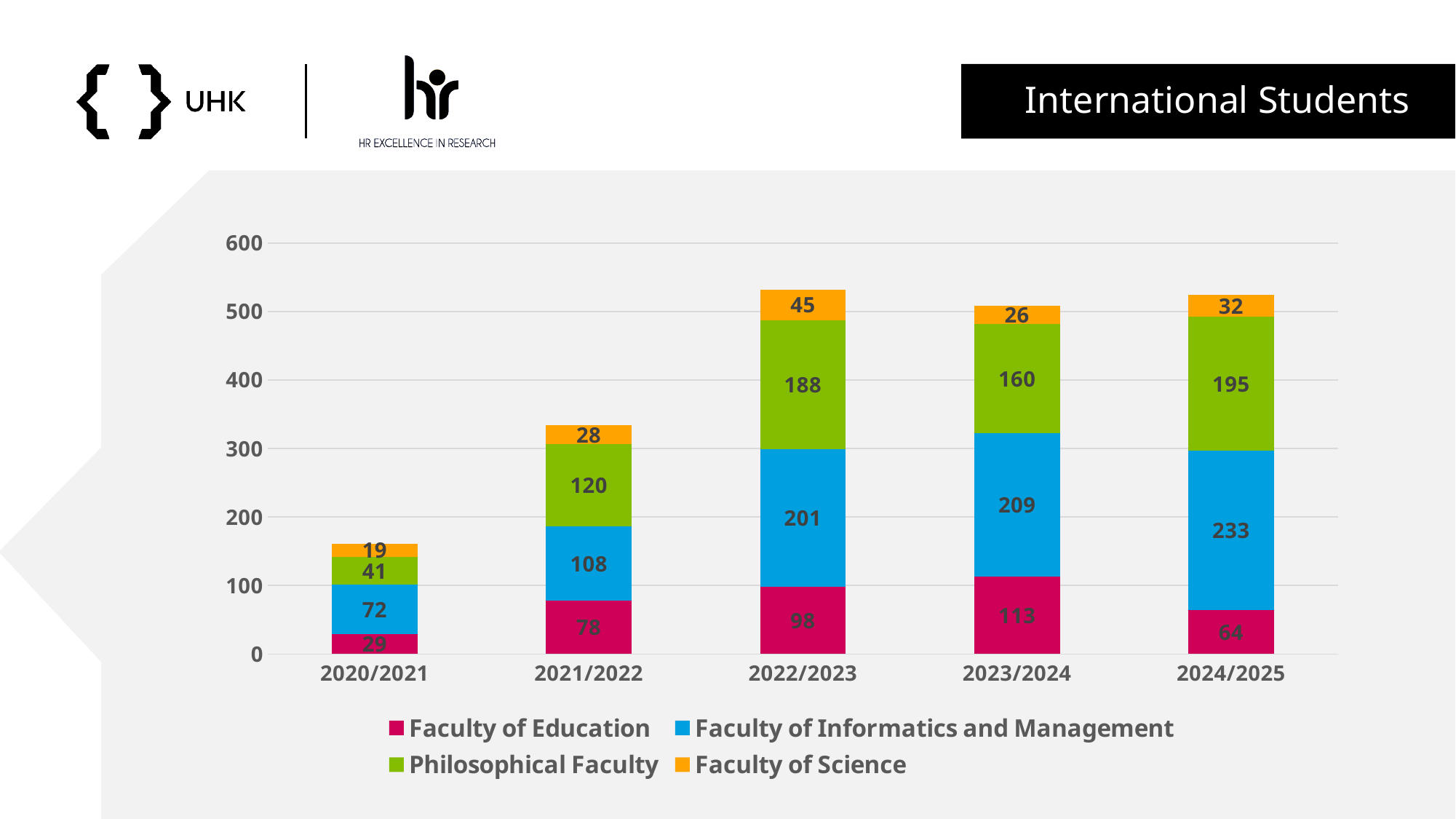
What is the value for the Faculty of Science in 2020/2021? 19 What is the value for the Faculty of Informatics and Management in 2024/2025? 233 In which academic year is the Faculty of Education value highest? 2023/2024 What kind of chart is shown on the slide? stacked bar chart What is the value for the Philosophical Faculty in 2022/2023? 188 How many series does the legend list? 4 Is the total of the stacked bar for 2022/2023 greater or less than 500? greater In which academic year is the Faculty of Science value lowest? 2020/2021 How many academic years are shown on the x axis? 5 What is the difference between the Faculty of Informatics and Management values in 2024/2025 and 2023/2024? 24 What is the total of the stacked bar for 2020/2021? 161 Which is larger: the Philosophical Faculty value in 2021/2022 or the Faculty of Informatics and Management value in 2021/2022? Philosophical Faculty